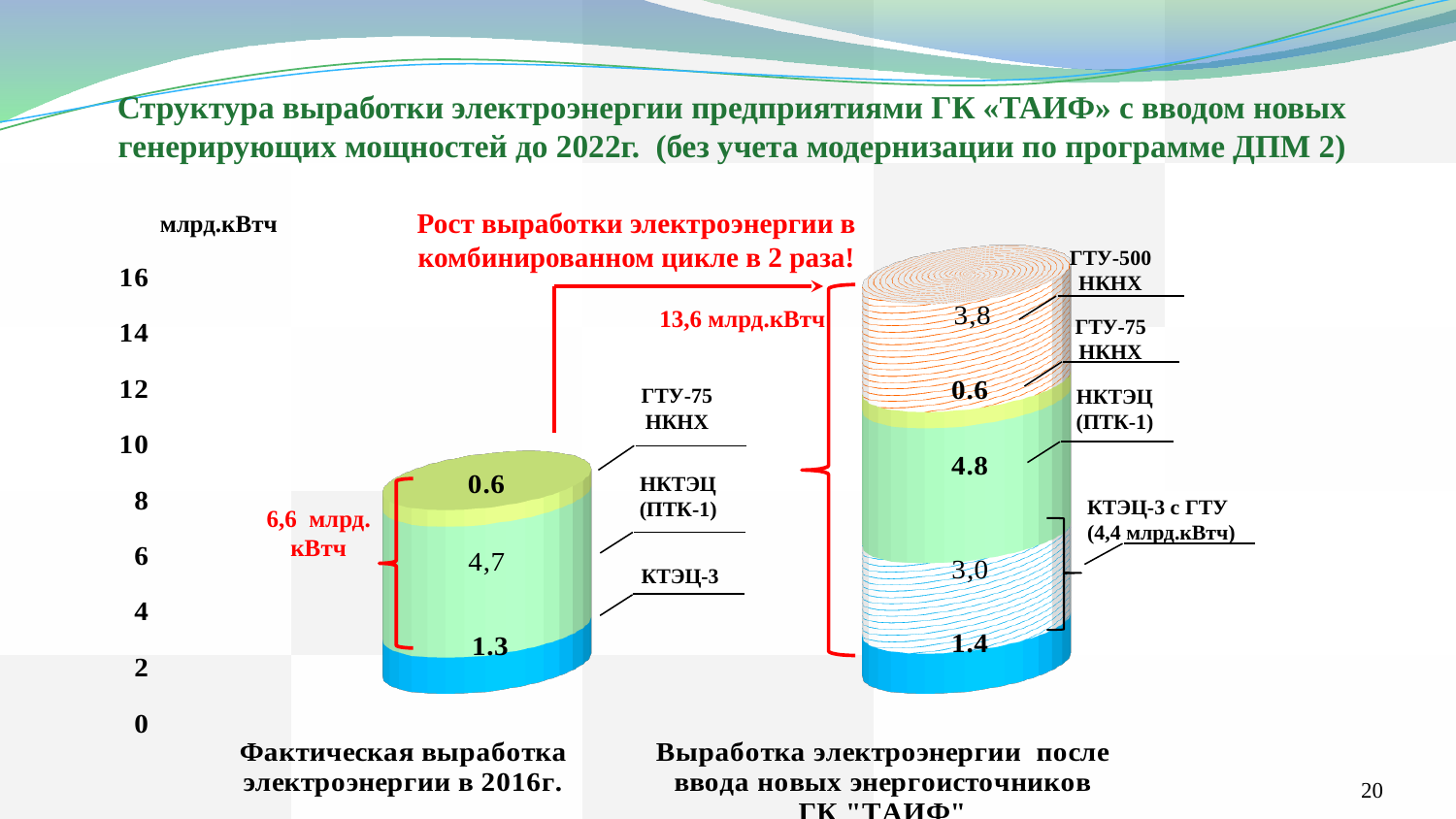
Which segment is the largest in the bar for generation after commissioning new energy sources? НКТЭЦ (ПТК-1) What combined value is given for КТЭЦ-3 с ГТУ in the bar after commissioning new energy sources? 4,4 млрд.кВтч What unit is shown on the vertical axis? млрд.кВтч What is the value for НКТЭЦ (ПТК-1) in the bar for actual generation in 2016 (Фактическая выработка электроэнергии в 2016г.)? 4,7 How many bars (categories) does the chart show? 2 What kind of chart is shown on the slide? stacked bar chart What is the total generation shown for the bar after commissioning new energy sources? 13,6 млрд.кВтч What is the value for ГТУ-500 НКНХ in the bar for generation after commissioning new energy sources? 3,8 What is the total generation shown for the 2016 bar? 6,6 млрд. кВтч What is the value for ГТУ-75 НКНХ in the bar for actual generation in 2016? 0.6 What is the value for КТЭЦ-3 in the bar for actual generation in 2016? 1.3 What is the value for НКТЭЦ (ПТК-1) in the bar for generation after commissioning new energy sources? 4.8